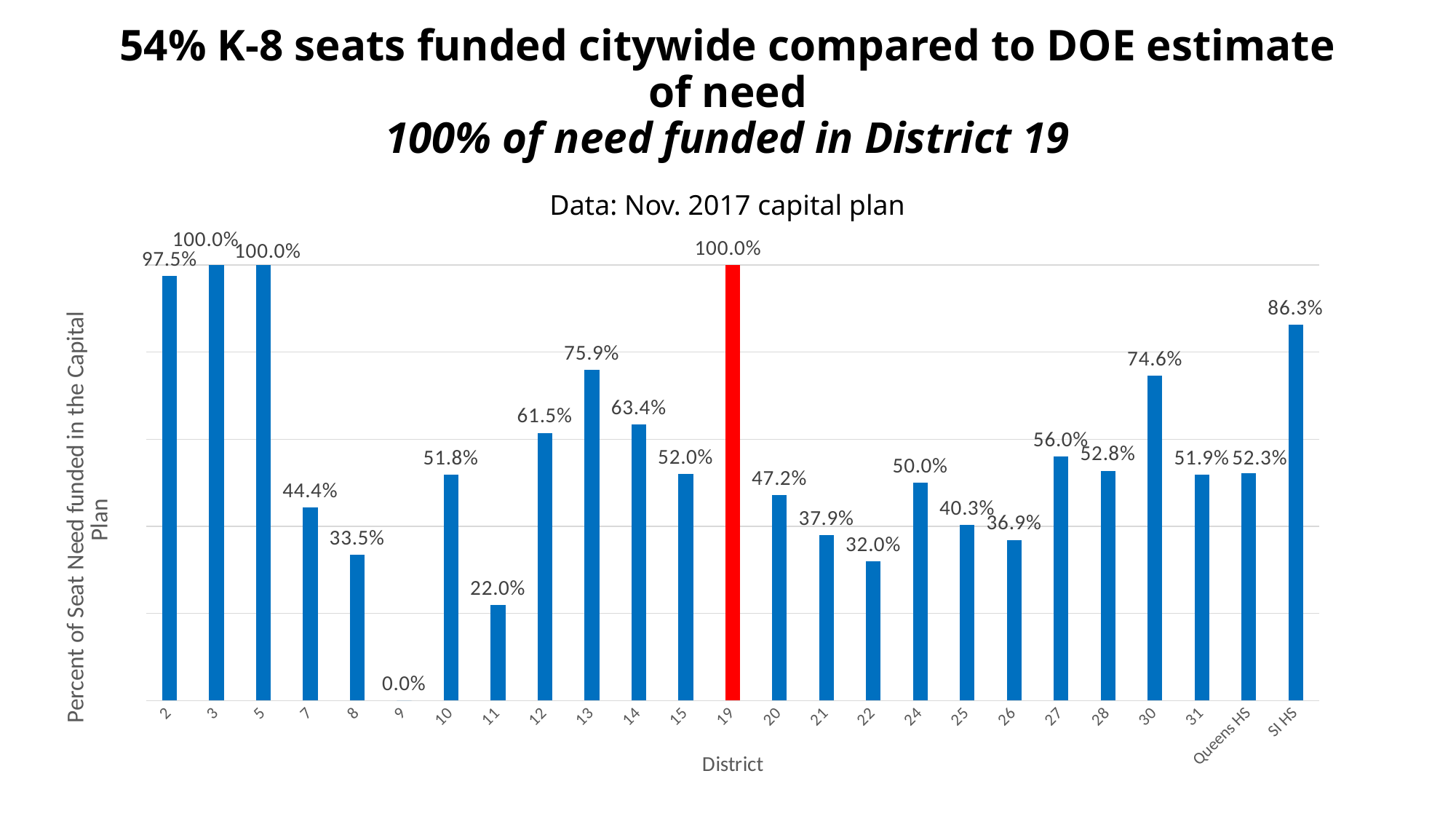
What percent of seat need is funded in the capital plan for District 13? 75.9% What is the difference between the values for District 30 and District 31? 22.7% What type of chart is shown on the slide? Bar chart Which has a lower percent of seat need funded, District 22 or District 26? District 22 Which has a higher percent of seat need funded, District 12 or District 14? District 14 What percent of seat need is funded for District 11? 22.0% What is the value shown for District 19, the red bar? 100.0% Which bar is highlighted in red? District 19 What is the value shown for SI HS? 86.3% How many districts or categories are shown on the x axis? 25 Which district has the lowest percent of seat need funded? District 9 What is the difference between the values for District 2 and District 8? 64.0%